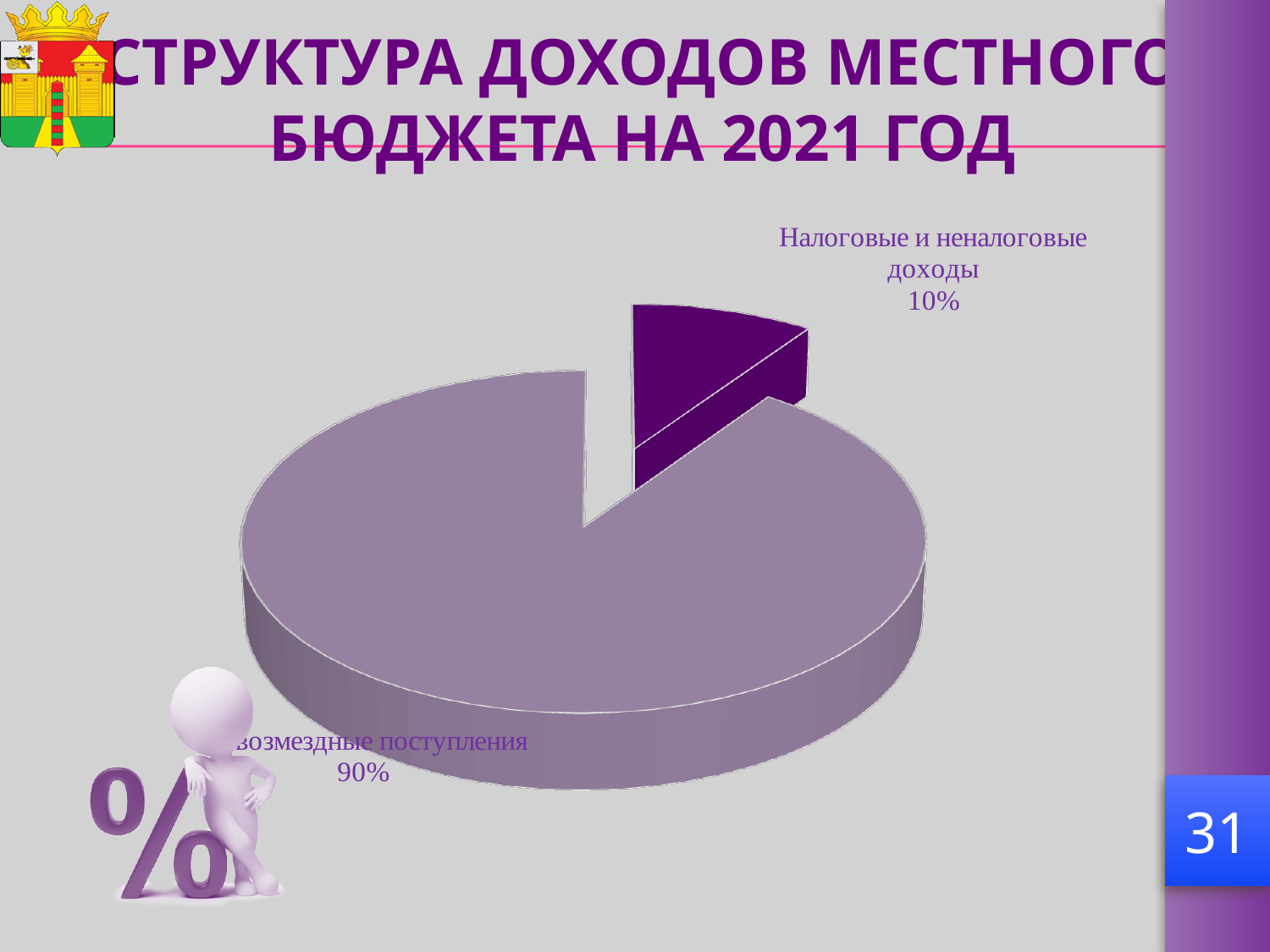
Which slice of the pie is the largest? Безвозмездные поступления What share of the pie is labelled "Безвозмездные поступления"? 90% What colour is the slice for "Налоговые и неналоговые доходы"? Dark purple By how many percentage points does "Безвозмездные поступления" exceed "Налоговые и неналоговые доходы"? 80 percentage points Which slice of the pie is the smallest? Налоговые и неналоговые доходы What kind of chart is shown on the slide? Pie chart How many slices does the pie chart have? 2 What do the two slice percentages add up to? 100% Which is larger: the share for "Налоговые и неналоговые доходы" or the share for "Безвозмездные поступления"? Безвозмездные поступления What share of the pie is labelled "Налоговые и неналоговые доходы"? 10% What is the title of the slide containing the pie chart? СТРУКТУРА ДОХОДОВ МЕСТНОГО БЮДЖЕТА НА 2021 ГОД